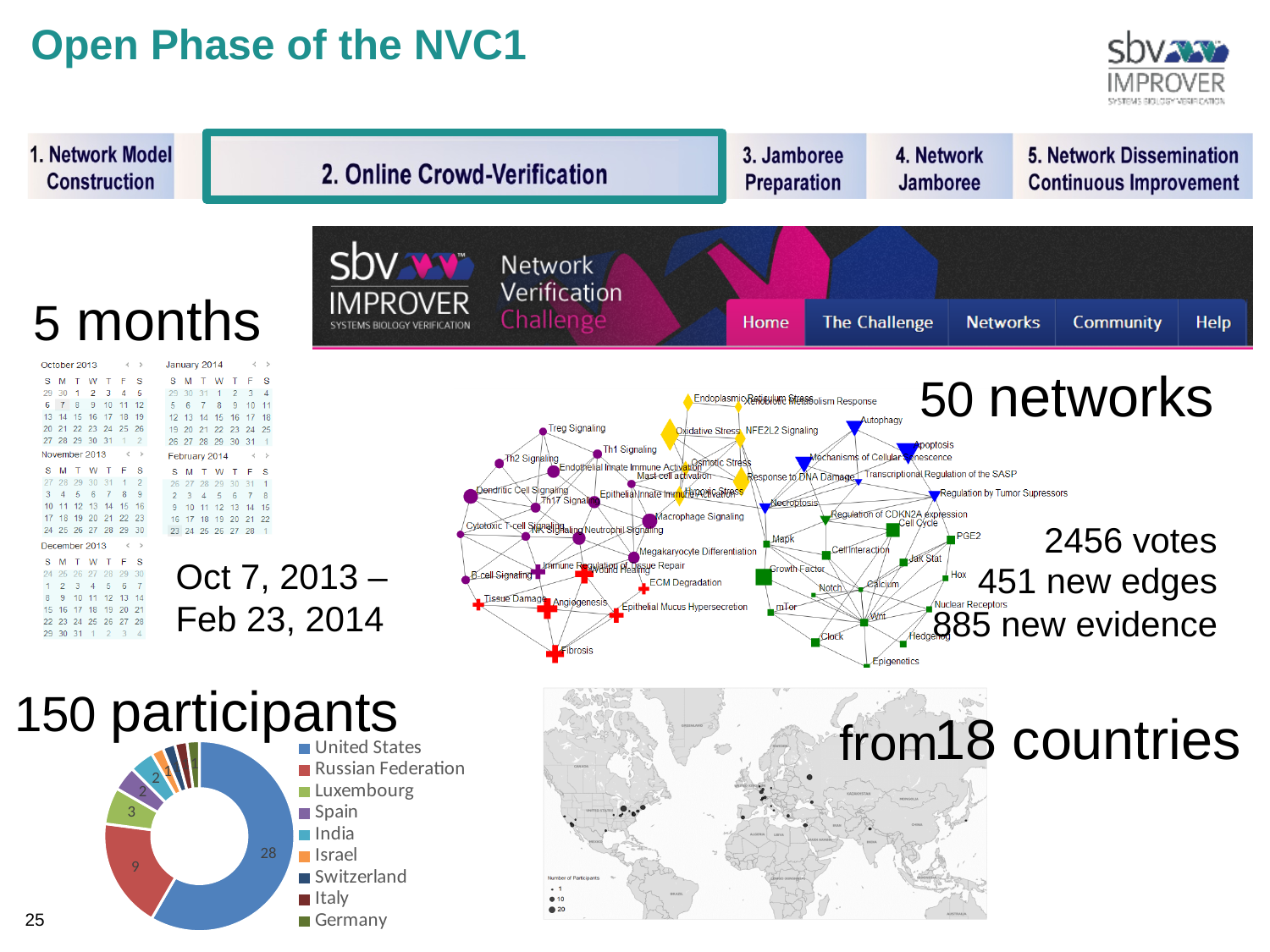
In the participants doughnut chart, which is larger: the value for Russian Federation or the value for Luxembourg? Russian Federation What kind of chart is shown at the bottom left of the slide under '150 participants'? doughnut chart In the participants doughnut chart, which country has the largest slice? United States How many countries does the legend of the participants doughnut chart list? 9 In the participants doughnut chart, what is the difference between the United States value and the Russian Federation value? 19 In the participants doughnut chart, what is the value for Russian Federation? 9 Which country is listed last in the legend of the participants doughnut chart? Germany In the participants doughnut chart, what is the value for United States? 28 In the participants doughnut chart, what is the value for Luxembourg? 3 In the participants doughnut chart, what is the difference between the Russian Federation value and the Luxembourg value? 6 Which country is listed first in the legend of the participants doughnut chart? United States